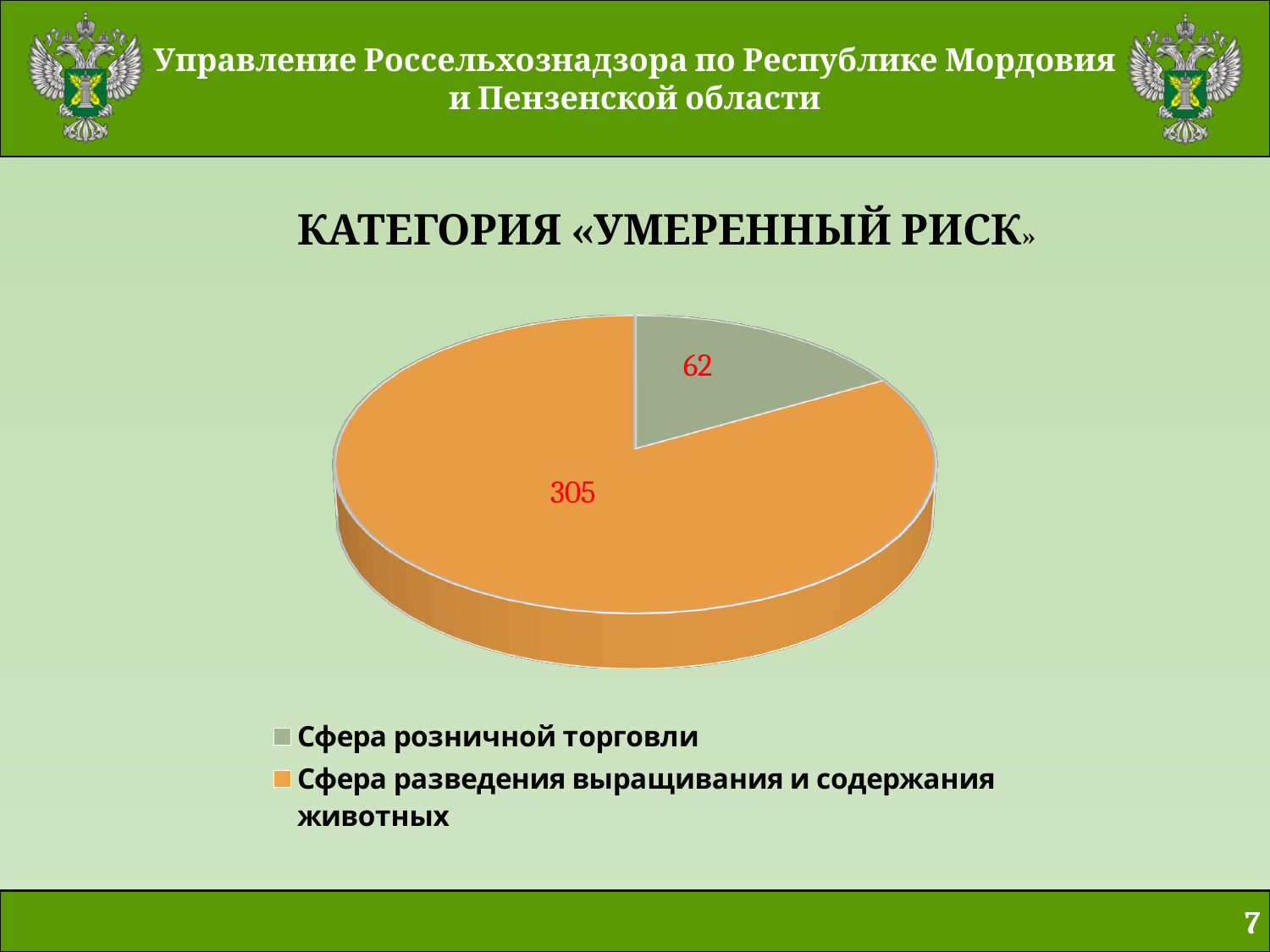
Which is larger: the value for «Сфера розничной торговли» or for «Сфера разведения выращивания и содержания животных»? Сфера разведения выращивания и содержания животных How many slices does the pie chart have? 2 What is the value for «Сфера розничной торговли»? 62 What is the difference between the values for «Сфера разведения выращивания и содержания животных» and «Сфера розничной торговли»? 243 How many entries does the legend list? 2 Which category has the largest slice of the pie? Сфера разведения выращивания и содержания животных What is the value for «Сфера разведения выращивания и содержания животных»? 305 What type of chart is shown on the slide? Pie chart What is the total of the two values shown in the pie chart? 367 Which category has the smallest slice of the pie? Сфера розничной торговли What is the title of the chart on the slide? КАТЕГОРИЯ «УМЕРЕННЫЙ РИСК»